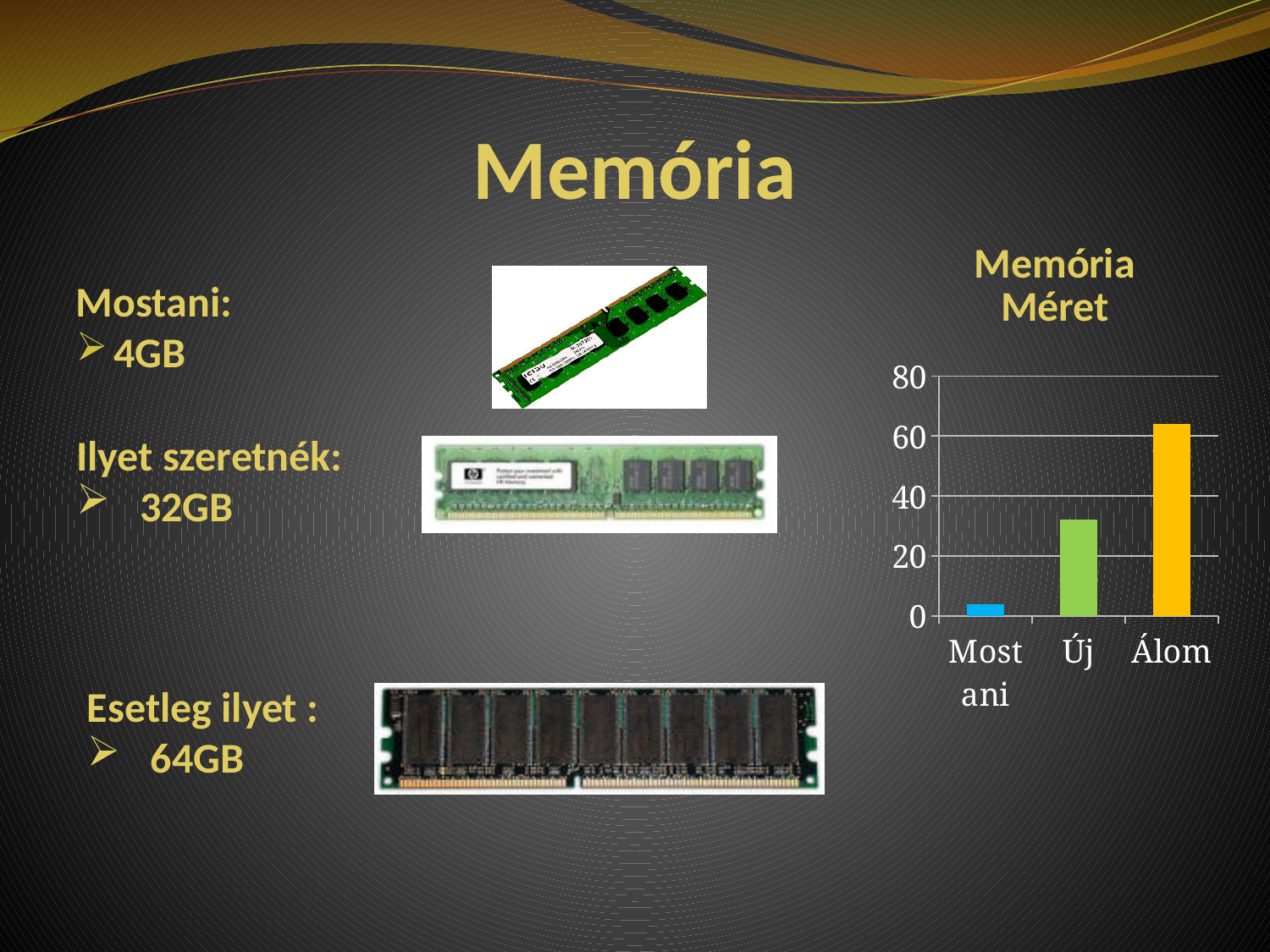
In the "Memória Méret" chart, which is larger, the value for Mostani or the value for Új? Új Which category has the highest bar in the "Memória Méret" chart? Álom How many categories are plotted in the "Memória Méret" chart? 3 In the "Memória Méret" chart, is the value for Álom greater or less than 60? greater In the "Memória Méret" chart, is the value for Mostani greater or less than 20? less In the "Memória Méret" chart, is the value for Új greater or less than 40? less What kind of chart is shown under the title "Memória Méret"? bar chart In the "Memória Méret" chart, which is larger, the value for Új or the value for Álom? Álom What is the title of the chart on the slide? Memória Méret Do the bars in the "Memória Méret" chart rise or fall from left to right? rise Which category has the lowest bar in the "Memória Méret" chart? Mostani